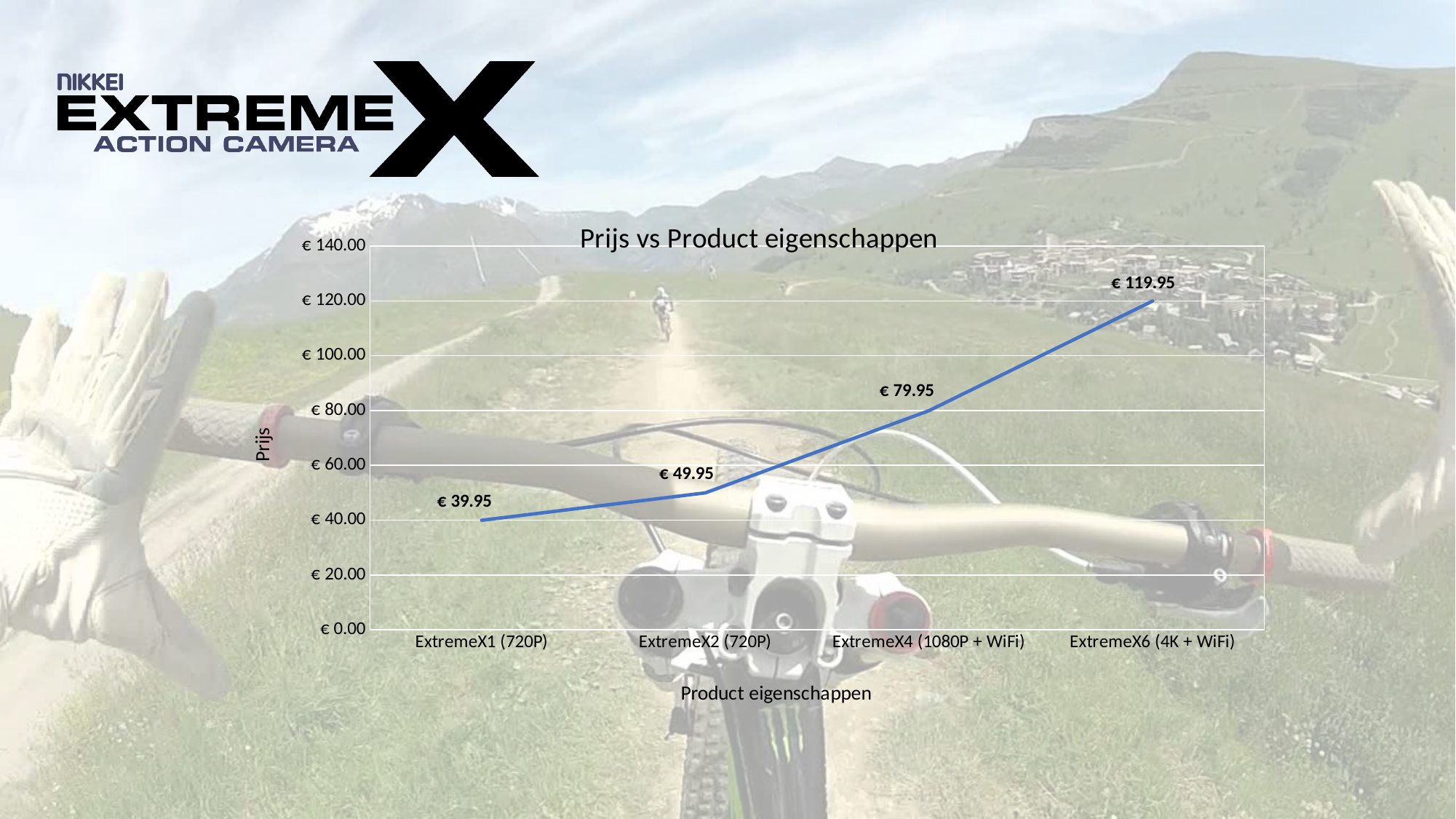
Is the price for ExtremeX6 (4K + WiFi) greater or less than € 100.00? greater What is the price shown for ExtremeX4 (1080P + WiFi)? € 79.95 What is the difference in price between ExtremeX2 (720P) and ExtremeX1 (720P)? € 10.00 What is the difference in price between ExtremeX6 (4K + WiFi) and ExtremeX4 (1080P + WiFi)? € 40.00 What is the title of the chart? Prijs vs Product eigenschappen What is the price shown for ExtremeX6 (4K + WiFi)? € 119.95 Which is priced higher, ExtremeX2 (720P) or ExtremeX4 (1080P + WiFi)? ExtremeX4 (1080P + WiFi) Which product has the highest price? ExtremeX6 (4K + WiFi) What is the price shown for ExtremeX1 (720P)? € 39.95 How many products are plotted on the chart? 4 What kind of chart is shown on the slide? line chart Which product has the lowest price? ExtremeX1 (720P)